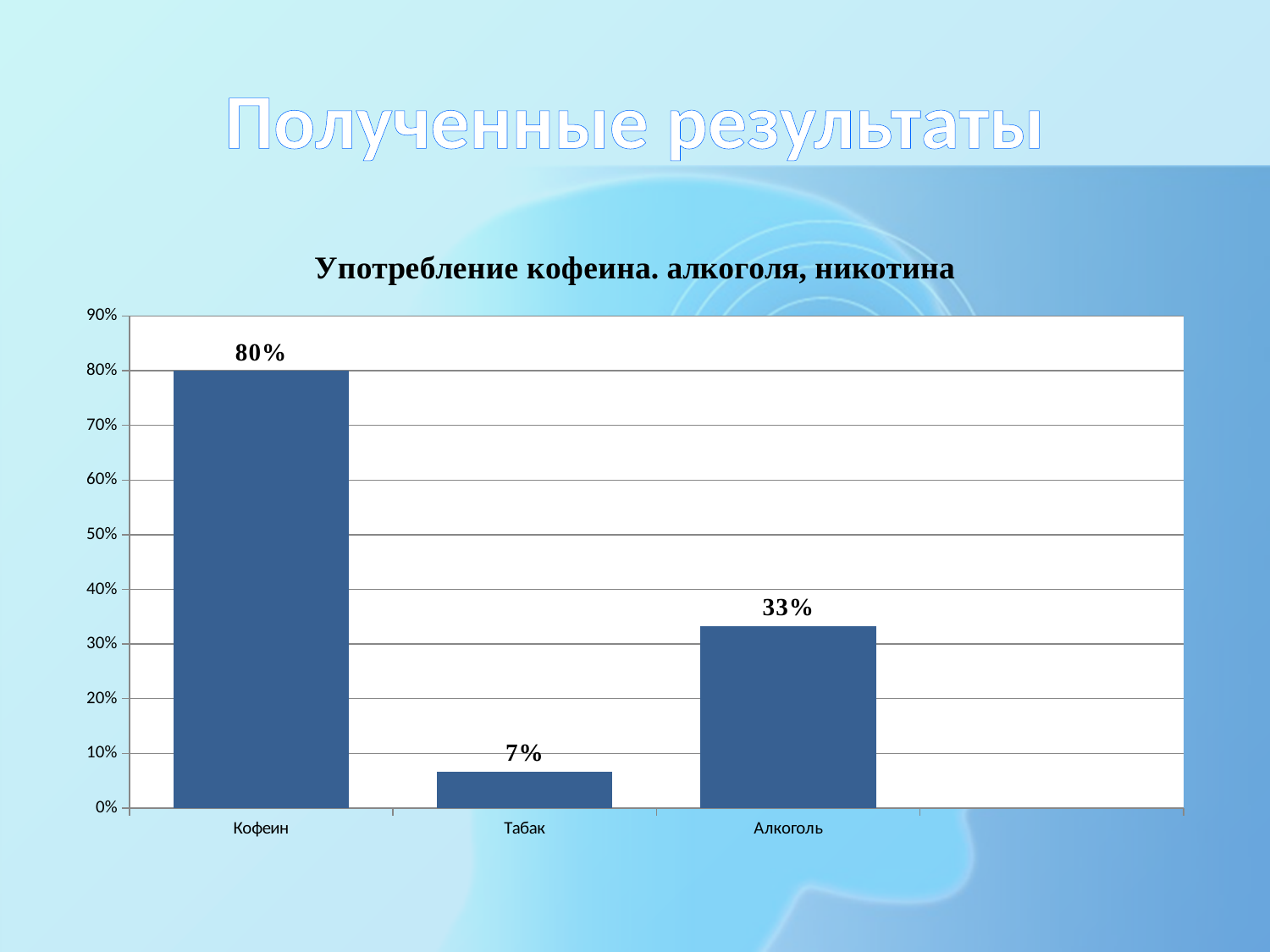
What is the value for Табак? 7% What is the title of the chart? Употребление кофеина. алкоголя, никотина Which is larger, the value for Алкоголь or the value for Табак? Алкоголь Which category has the lowest value? Табак What is the difference between the values for Кофеин and Алкоголь? 47% What is the value for Кофеин? 80% Is the value for Алкоголь greater or less than 40%? less What kind of chart is shown on the slide? bar chart How many categories are shown on the x axis? 3 What is the difference between the values for Алкоголь and Табак? 26% What is the value for Алкоголь? 33% Which category has the highest value? Кофеин